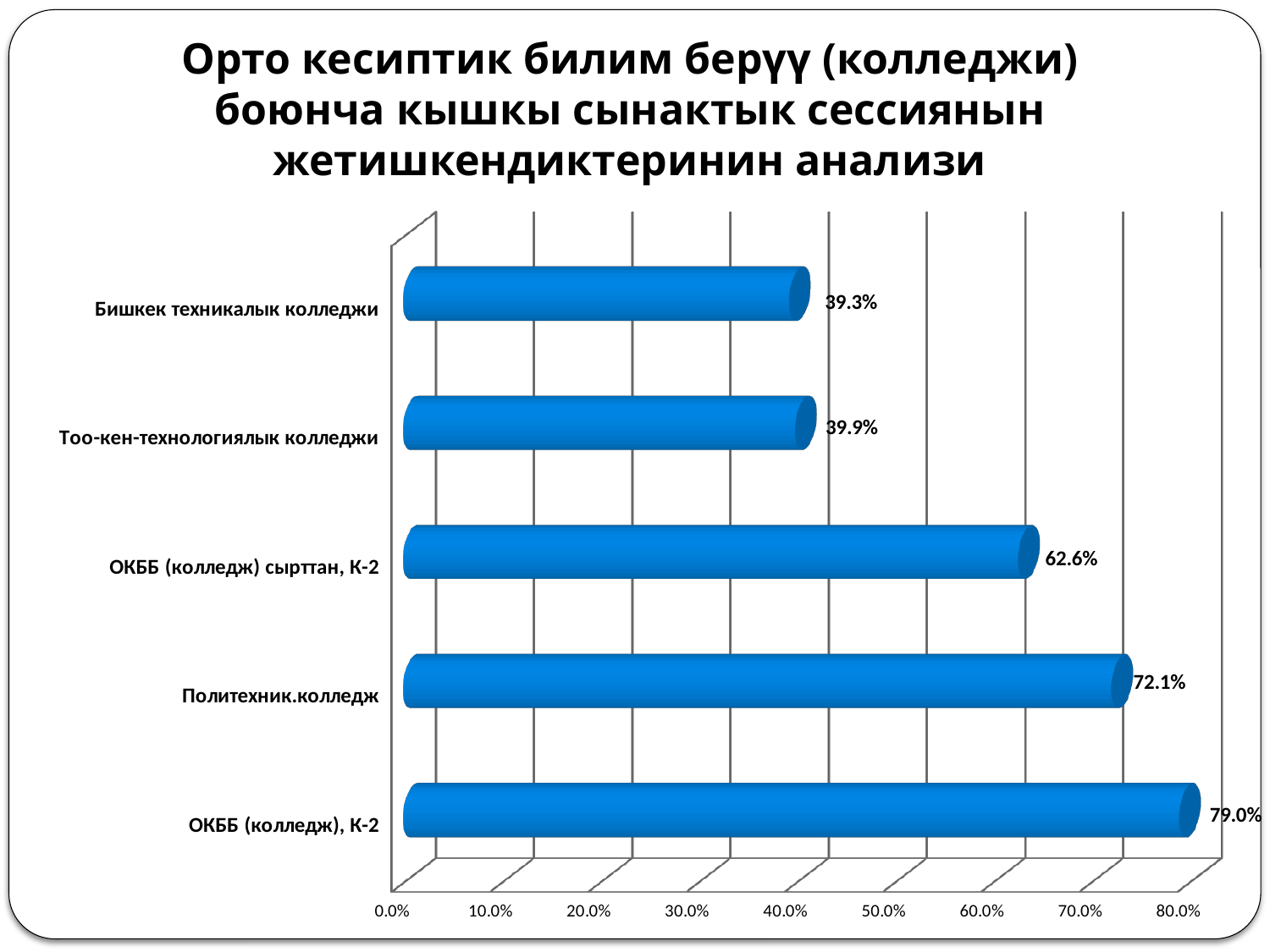
Which is larger, the value for ОКББ (колледж) сырттан, К-2 or the value for Тоо-кен-технологиялык колледжи? ОКББ (колледж) сырттан, К-2 Which category has the highest value? ОКББ (колледж), К-2 What kind of chart is shown on the slide? bar chart What is the value for ОКББ (колледж) сырттан, К-2? 62.6% Is the value for Политехник.колледж greater or less than 70.0%? greater What is the difference between the values for ОКББ (колледж), К-2 and Политехник.колледж? 6.9% What is the value of the highest tick label on the horizontal axis? 80.0% Which category has the lowest value? Бишкек техникалык колледжи What is the difference between the values for Тоо-кен-технологиялык колледжи and Бишкек техникалык колледжи? 0.6% What is the value for Бишкек техникалык колледжи? 39.3% How many categories are shown in the chart? 5 What is the value for Политехник.колледж? 72.1%